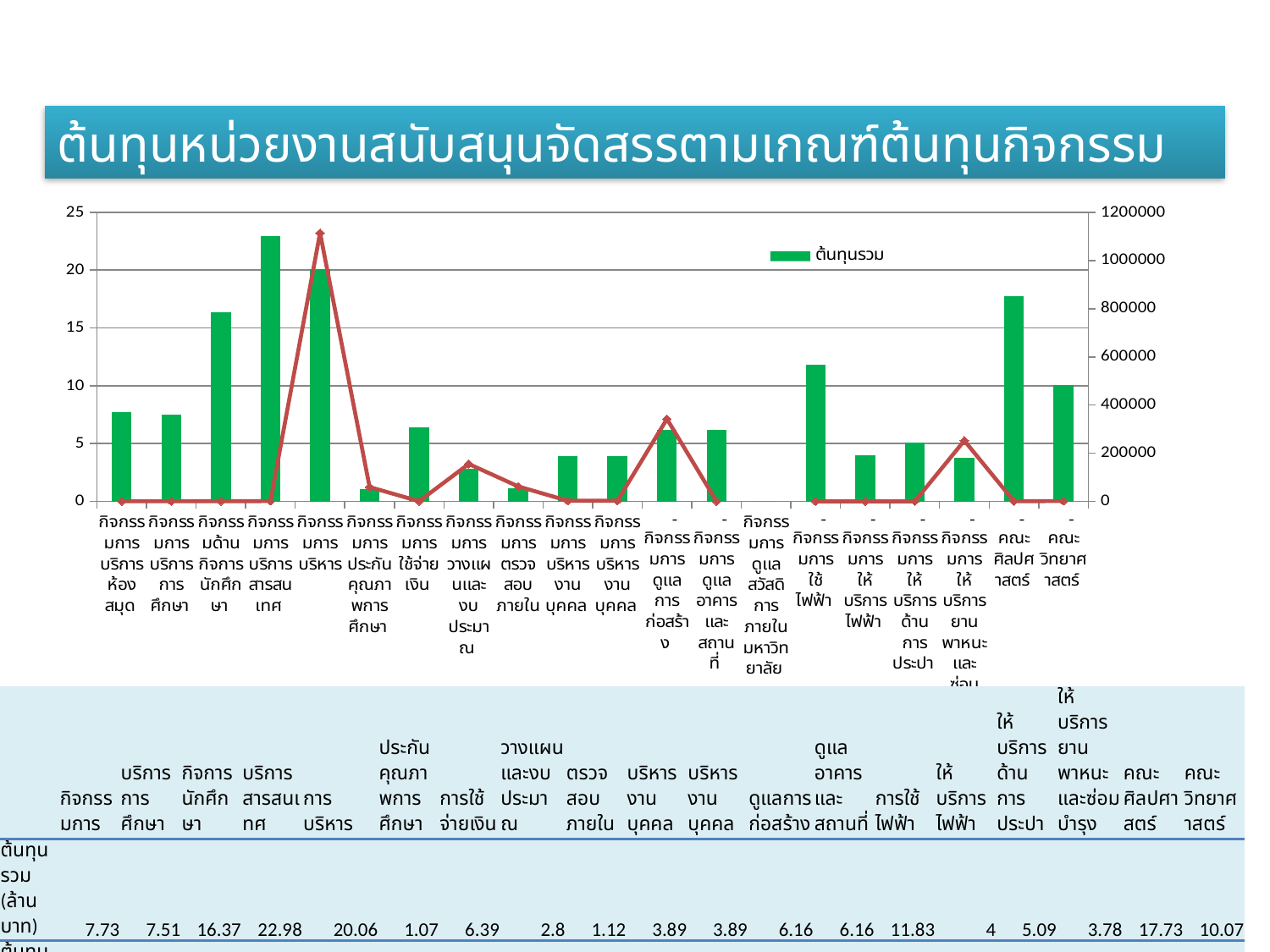
What kind of chart is shown on the slide? combination bar and line chart What is the ต้นทุนรวม (ล้านบาท) value for กิจกรรมการใช้ไฟฟ้า? 11.83 Is the ต้นทุนรวม bar for กิจกรรมด้านกิจการนักศึกษา greater or less than 15? greater Which category has the highest ต้นทุนรวม bar? กิจกรรมการบริการสารสนเทศ What is the difference in ต้นทุนรวม between คณะศิลปศาสตร์ and คณะวิทยาศาสตร์? 7.66 What is the difference in ต้นทุนรวม between กิจกรรมการบริการสารสนเทศ and กิจกรรมการบริหาร? 2.92 What is the ต้นทุนรวม (ล้านบาท) value for คณะศิลปศาสตร์? 17.73 What is the name of the series shown in the chart legend? ต้นทุนรวม What is the ต้นทุนรวม (ล้านบาท) value for กิจกรรมการวางแผนและงบประมาณ? 2.8 What is the ต้นทุนรวม (ล้านบาท) value for กิจกรรมการบริหาร? 20.06 Which has the larger ต้นทุนรวม, คณะศิลปศาสตร์ or คณะวิทยาศาสตร์? คณะศิลปศาสตร์ How many series does the chart legend list? 1